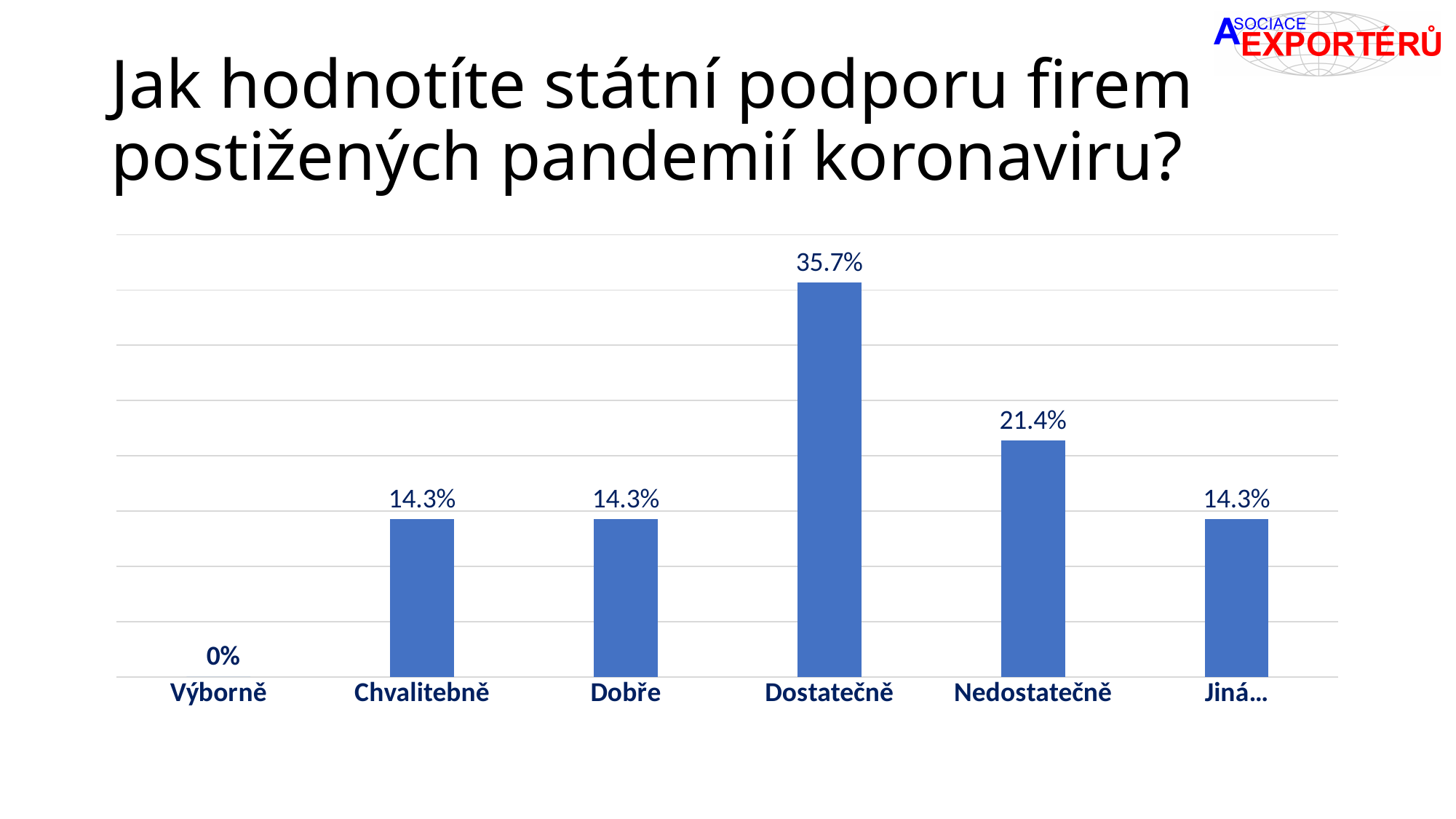
Which category has the lowest value? Výborně What is the value for Dostatečně? 35.7% What is the difference between the values for Nedostatečně and Dobře? 7.1% What is the difference between the values for Dostatečně and Nedostatečně? 14.3% What kind of chart is shown on the slide? Bar chart How many categories are shown on the x axis? 6 What is the value for Chvalitebně? 14.3% Which is larger, the value for Dostatečně or the value for Nedostatečně? Dostatečně What is the value for Výborně? 0% What is the value for Nedostatečně? 21.4% Which category has the highest value? Dostatečně What is the title of the slide containing the chart? Jak hodnotíte státní podporu firem postižených pandemií koronaviru?